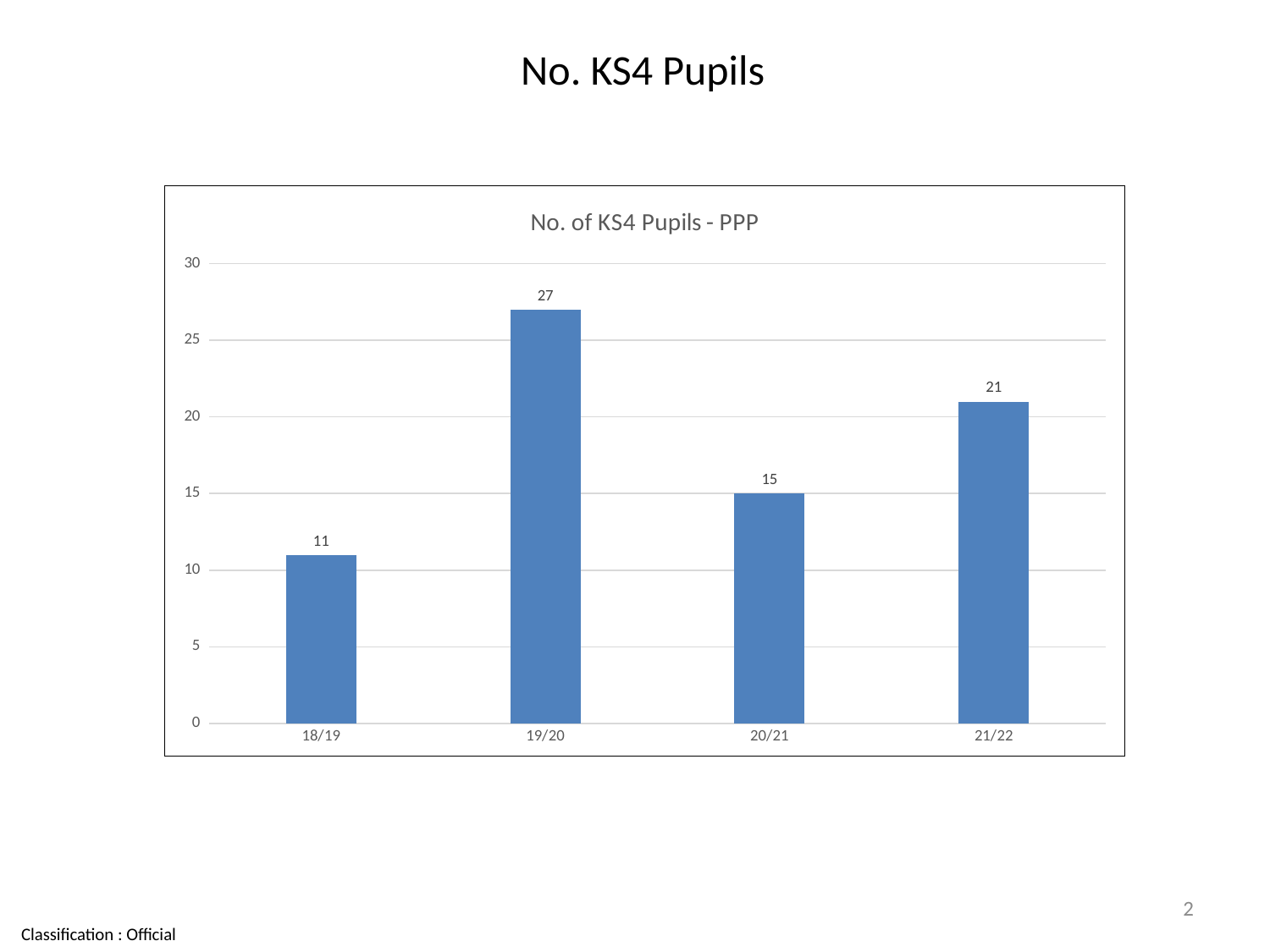
What is the title of the chart? No. of KS4 Pupils - PPP How many years are shown on the chart? 4 Which year has the lowest number of KS4 pupils? 18/19 What is the number of KS4 pupils for 18/19? 11 What is the number of KS4 pupils for 20/21? 15 What is the difference in the number of KS4 pupils between 21/22 and 20/21? 6 Which year has the highest number of KS4 pupils? 19/20 Which year has more KS4 pupils, 20/21 or 21/22? 21/22 What is the number of KS4 pupils for 21/22? 21 What kind of chart is shown on the slide? Bar chart What is the number of KS4 pupils for 19/20? 27 What is the difference in the number of KS4 pupils between 19/20 and 18/19? 16